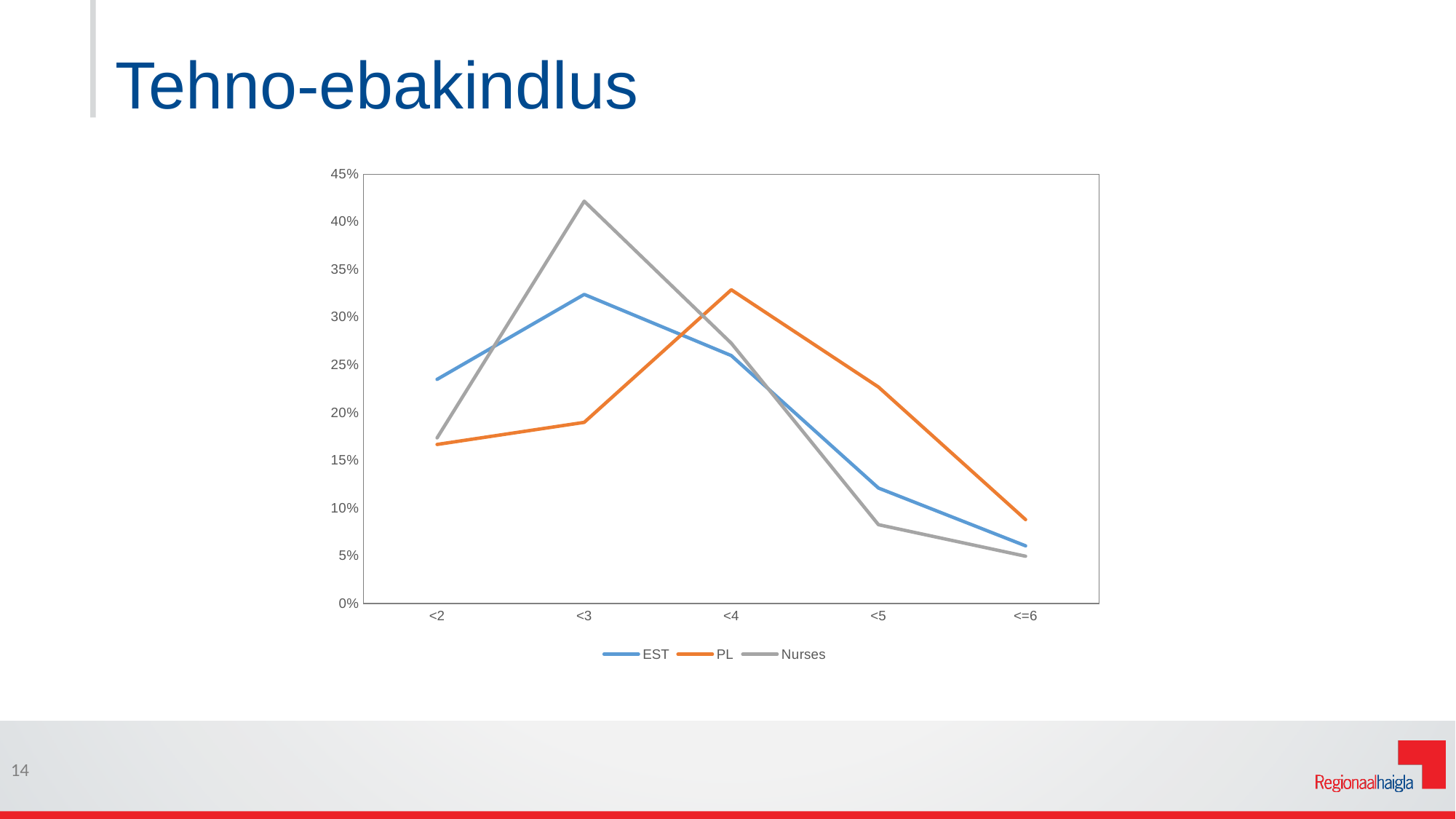
At which category does the PL series reach its highest value? <4 Is the value for Nurses at <3 greater or less than 40%? greater How many categories are shown on the x axis? 5 Is the value for PL at <2 greater or less than 20%? less At which category does the EST series reach its highest value? <3 At which category does the Nurses series reach its lowest value? <=6 At category <=6, which series has the larger value, PL or EST? PL How many series does the legend list? 3 Does the EST series rise or fall from <3 to <=6? fall At category <3, which series has the larger value, EST or Nurses? Nurses What kind of chart is shown on the slide? line chart At which category does the Nurses series reach its highest value? <3